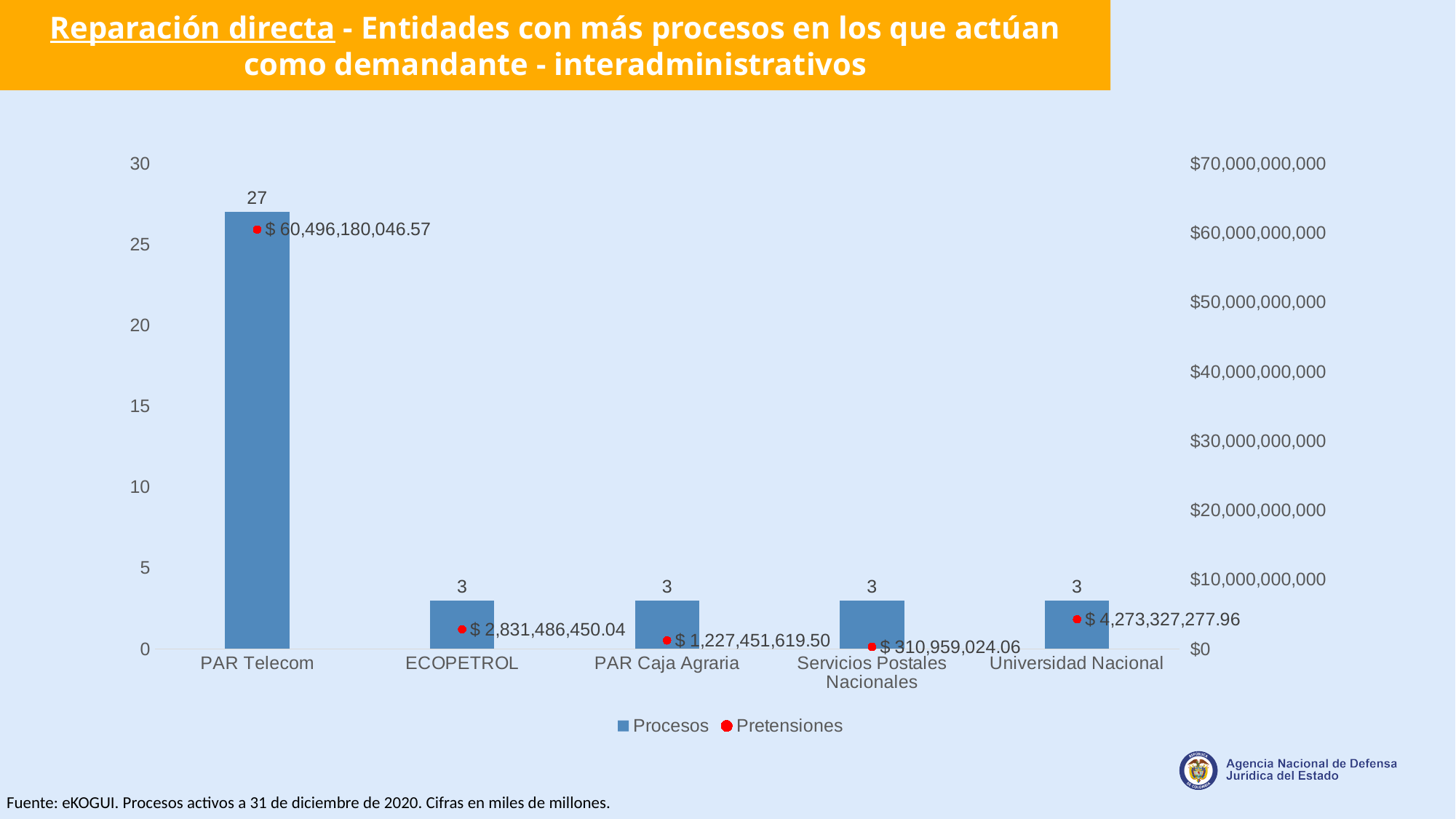
How many entities are shown on the x axis? 5 How many series does the legend list? 2 What is the Pretensiones value for ECOPETROL? $ 2,831,486,450.04 What kind of chart is used to show the Procesos series? Bar chart How many Procesos does PAR Telecom have? 27 Which entity has the lowest Pretensiones value? Servicios Postales Nacionales What is the difference in Procesos between PAR Telecom and ECOPETROL? 24 Which entity has the highest number of Procesos? PAR Telecom How many Procesos does Universidad Nacional have? 3 Which has a larger Pretensiones value, Universidad Nacional or PAR Caja Agraria? Universidad Nacional What is the Pretensiones value for PAR Telecom? $ 60,496,180,046.57 What is the Pretensiones value for Servicios Postales Nacionales? $ 310,959,024.06